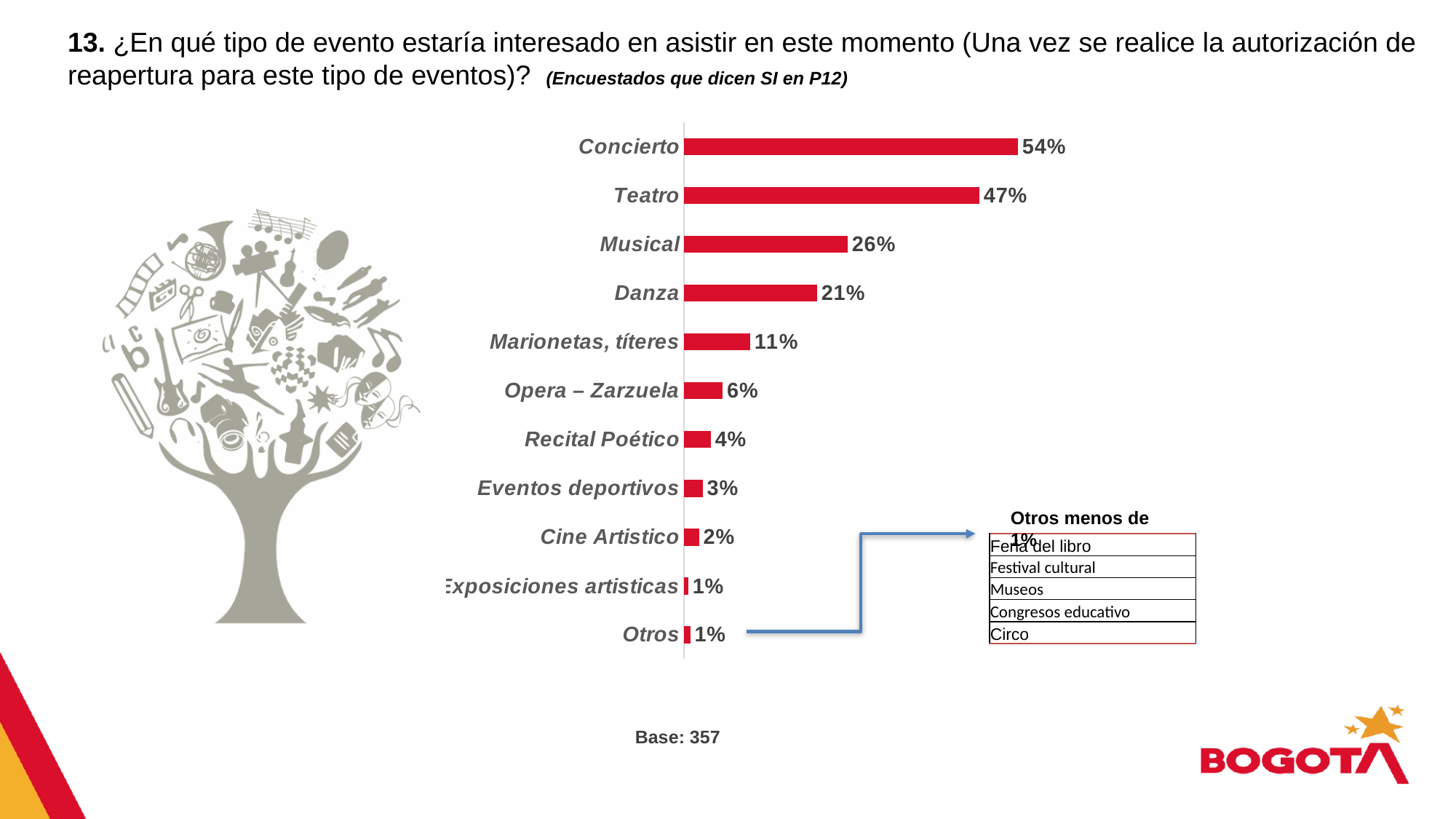
What kind of chart is shown on the slide? Bar chart What is the difference between the values for Concierto and Teatro? 7% What is the base (number of respondents) shown below the chart? 357 How many categories are shown in the bar chart? 11 What is the value for Concierto? 54% What is the difference between the values for Musical and Danza? 5% What is the value for Danza? 21% What colour are the bars in the chart? Red What is the value for Marionetas, títeres? 11% Which is larger, the value for Opera – Zarzuela or the value for Recital Poético? Opera – Zarzuela Which category has the highest value? Concierto What is the value for Teatro? 47%